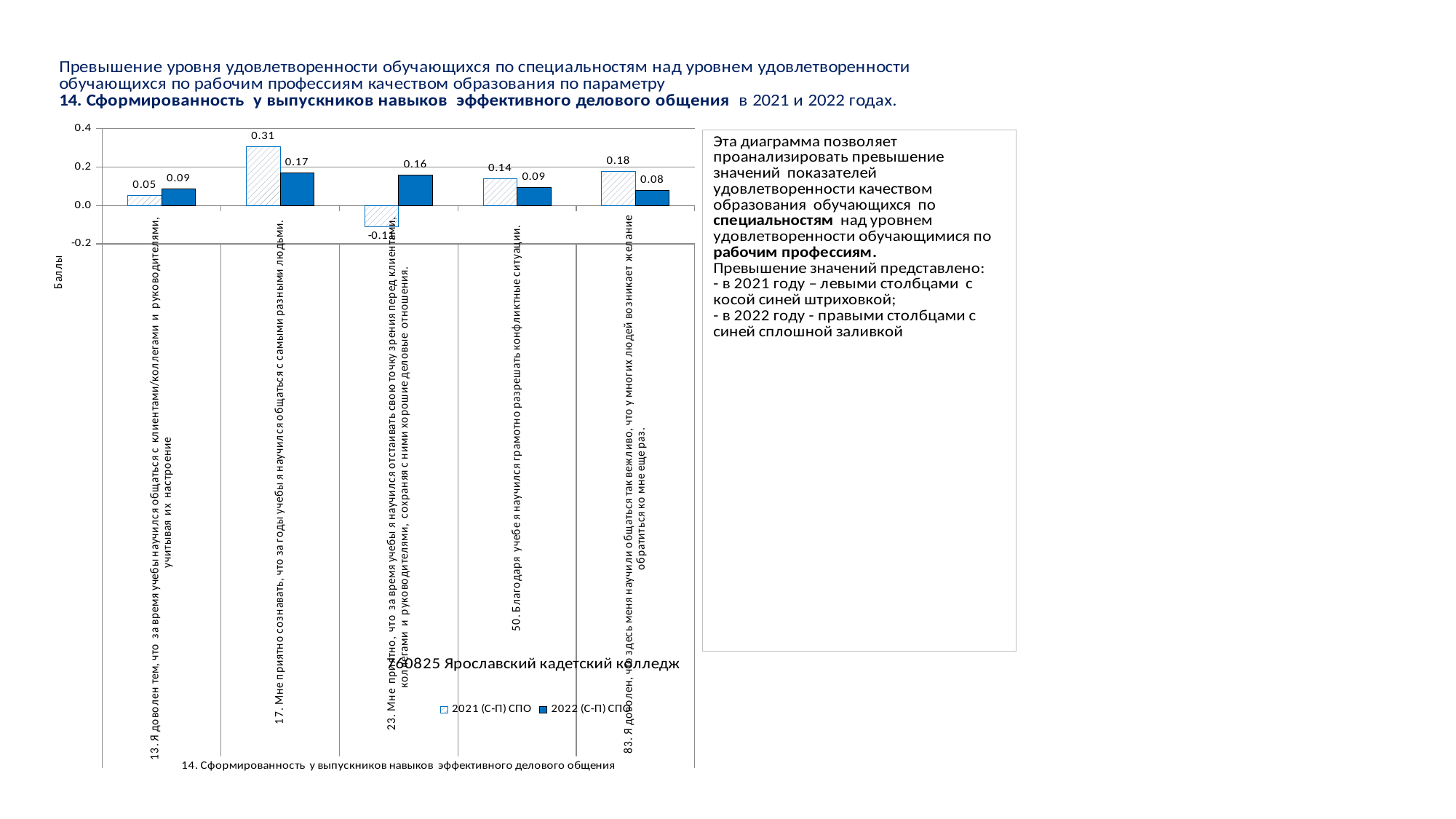
How many categories (statements) are plotted on the chart? 5 For statement 13 ("Я доволен тем, что за время учебы научился общаться с клиентами/коллегами и руководителями..."), which series has the larger value, 2021 (С-П) СПО or 2022 (С-П) СПО? 2022 (С-П) СПО What is the 2022 (С-П) СПО value for statement 23 ("Мне приятно, что за время учебы я научился отстаивать свою точку зрения...")? 0.16 What is the 2021 (С-П) СПО value for statement 17 ("Мне приятно сознавать, что за годы учебы я научился общаться с самыми разными людьми")? 0.31 What is the 2022 (С-П) СПО value for statement 83 ("Я доволен, что здесь меня научили общаться так вежливо...")? 0.08 What is the label of the vertical axis? Баллы Which statement has the lowest 2022 (С-П) СПО value? 83. Я доволен, что здесь меня научили общаться так вежливо, что у многих людей возникает желание обратиться ко мне еще раз How many series does the chart legend list? 2 What is the difference between the 2021 and 2022 values for statement 17? 0.14 What kind of chart is shown on the slide? bar chart Is the 2021 (С-П) СПО value for statement 23 greater or less than 0.0? less Which statement has the highest 2021 (С-П) СПО value? 17. Мне приятно сознавать, что за годы учебы я научился общаться с самыми разными людьми